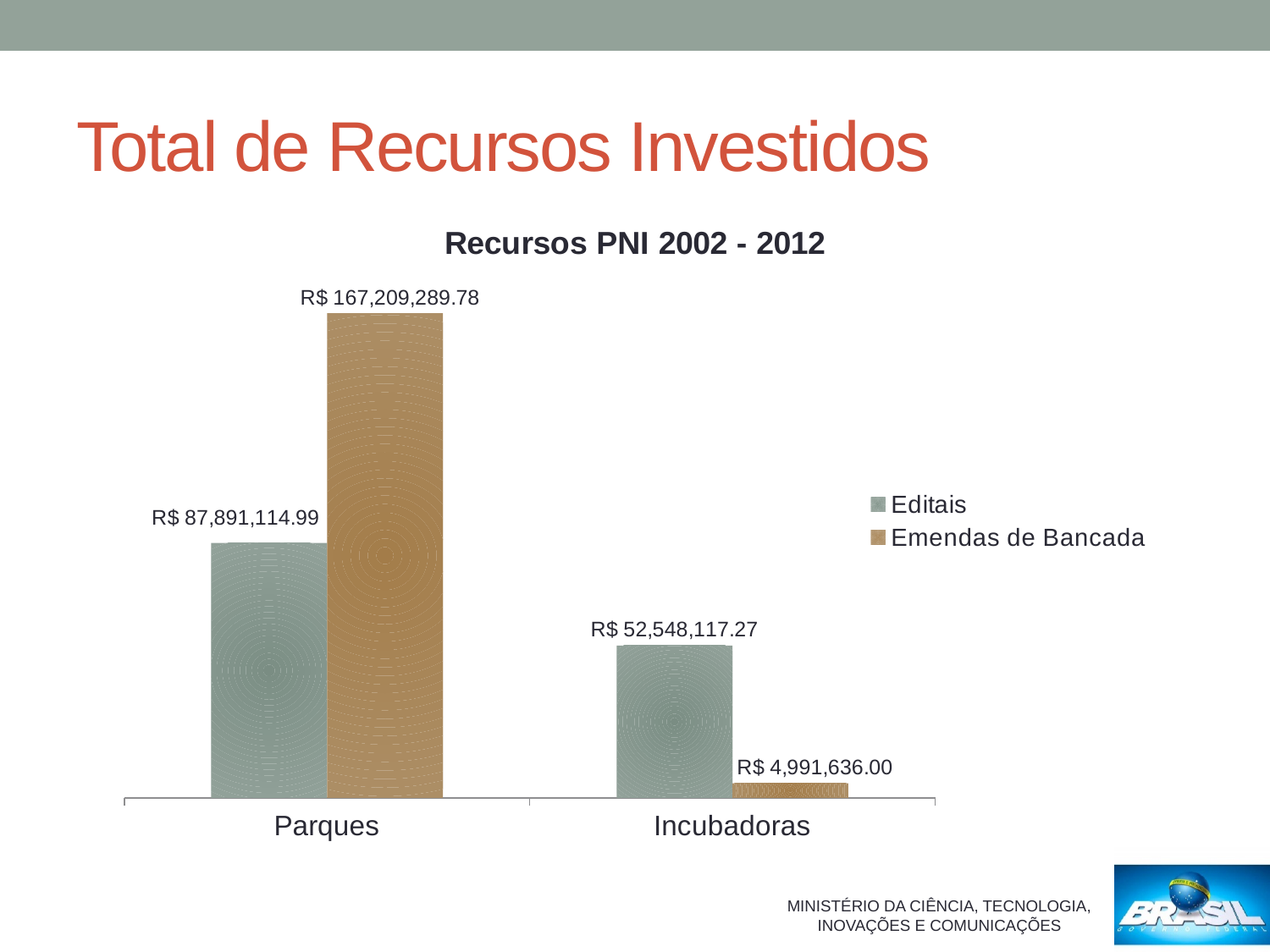
Which bar has the lowest value in the chart? Emendas de Bancada for Incubadoras What is the value of Editais for Incubadoras? R$ 52,548,117.27 What is the value of Emendas de Bancada for Parques? R$ 167,209,289.78 What is the difference between Editais for Parques and Editais for Incubadoras? R$ 35,342,997.72 Which is larger for Incubadoras, Editais or Emendas de Bancada? Editais What is the value of Emendas de Bancada for Incubadoras? R$ 4,991,636.00 How many categories are shown on the x axis? 2 Which bar has the highest value in the chart? Emendas de Bancada for Parques What kind of chart is shown on the slide? Bar chart What is the value of Editais for Parques? R$ 87,891,114.99 What is the difference between Emendas de Bancada and Editais for Parques? R$ 79,318,174.79 How many series does the legend list? 2